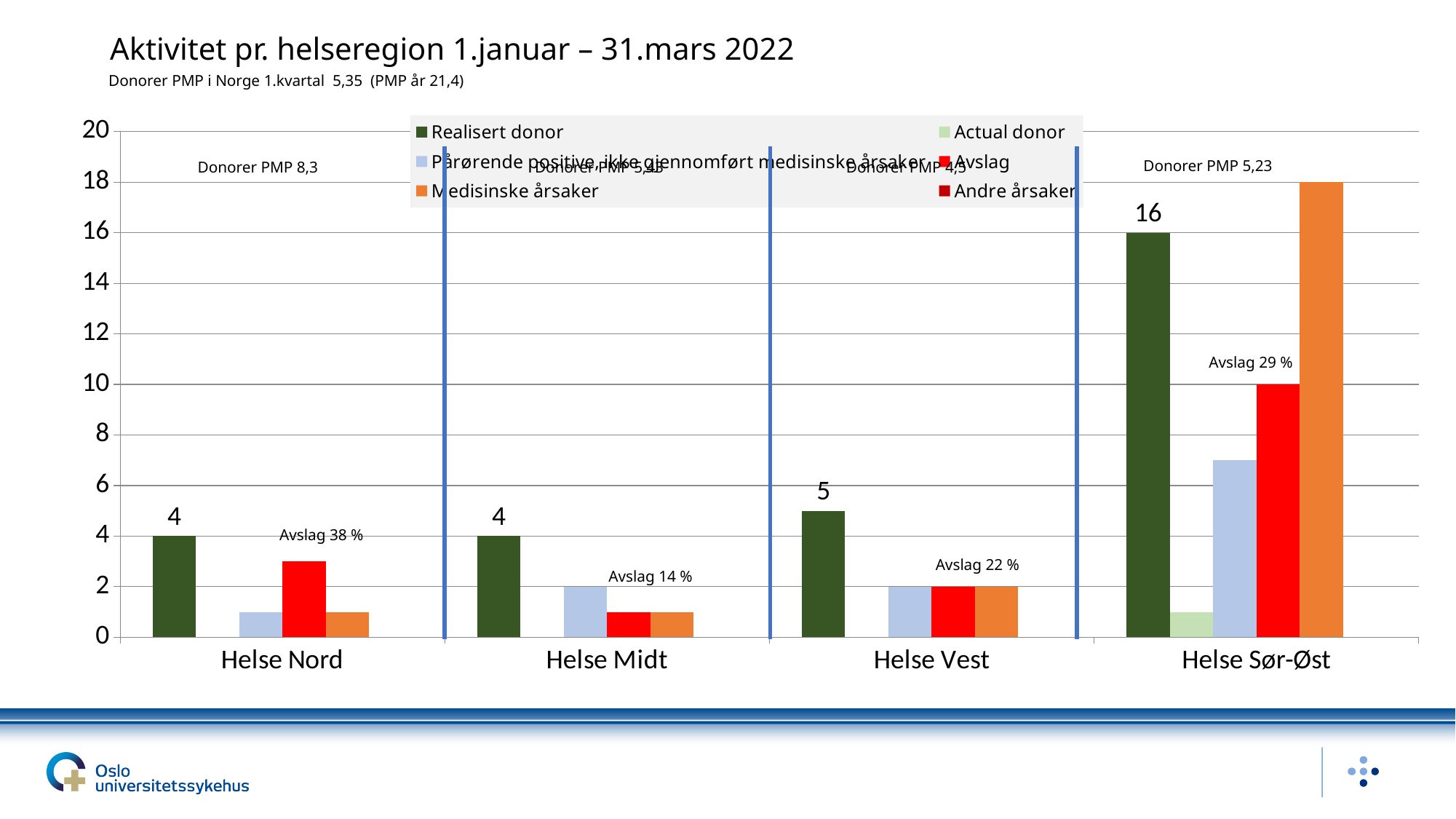
What is the value of Avslag for Helse Sør-Øst? 10 What Avslag percentage is labelled for Helse Nord? Avslag 38 % What is the difference between the Realisert donor values for Helse Sør-Øst and Helse Nord? 12 Which region has the highest Realisert donor value? Helse Sør-Øst Which has a larger Realisert donor value, Helse Vest or Helse Midt? Helse Vest What is the value of Realisert donor for Helse Vest? 5 What kind of chart is shown on the slide? Bar chart How many health regions are shown on the x axis? 4 What is the value of Realisert donor for Helse Sør-Øst? 16 How many series does the legend list? 6 Is the value for Pårørende positive ikke gjennomført medisinske årsaker for Helse Sør-Øst greater or less than 8? less What is the value of Medisinske årsaker for Helse Sør-Øst? 18